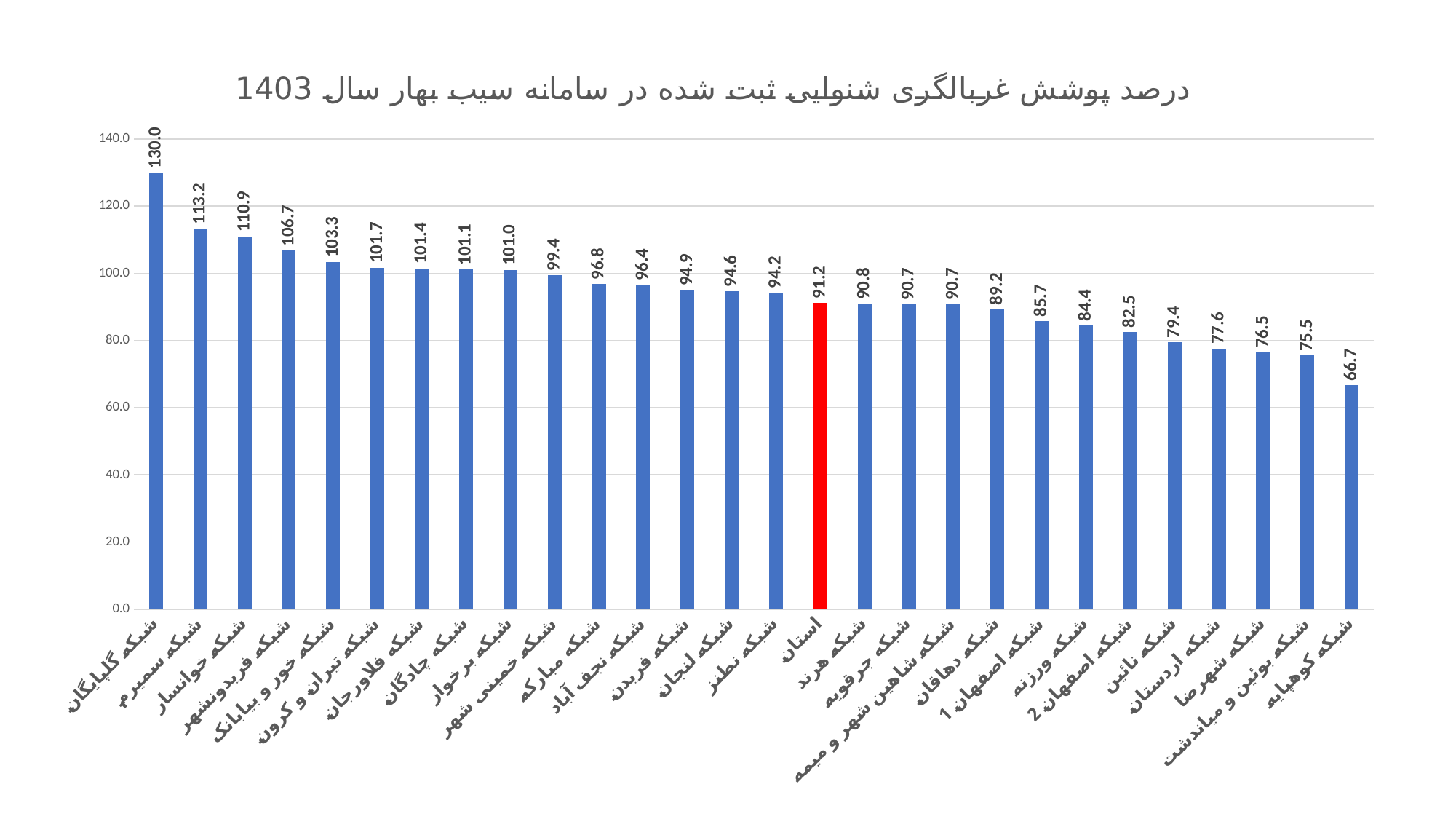
What is the value for استان (the red bar)? 91.2 What is the difference between the values for شبکه سمیرم and شبکه خوانسار? 2.3 Which category has the lowest value? شبکه کوهپایه What is the value for شبکه گلپایگان? 130.0 Which is larger, the value for شبکه دهاقان or the value for شبکه ورزنه? شبکه دهاقان What kind of chart is shown on the slide? bar chart Is the value for شبکه نائین greater or less than 80.0? less How many bars are shown in the chart? 28 Do the values rise or fall from left to right along the x axis? fall What is the value for شبکه نجف آباد? 96.4 Which bar is coloured red instead of blue? استان Which category has the highest value? شبکه گلپایگان